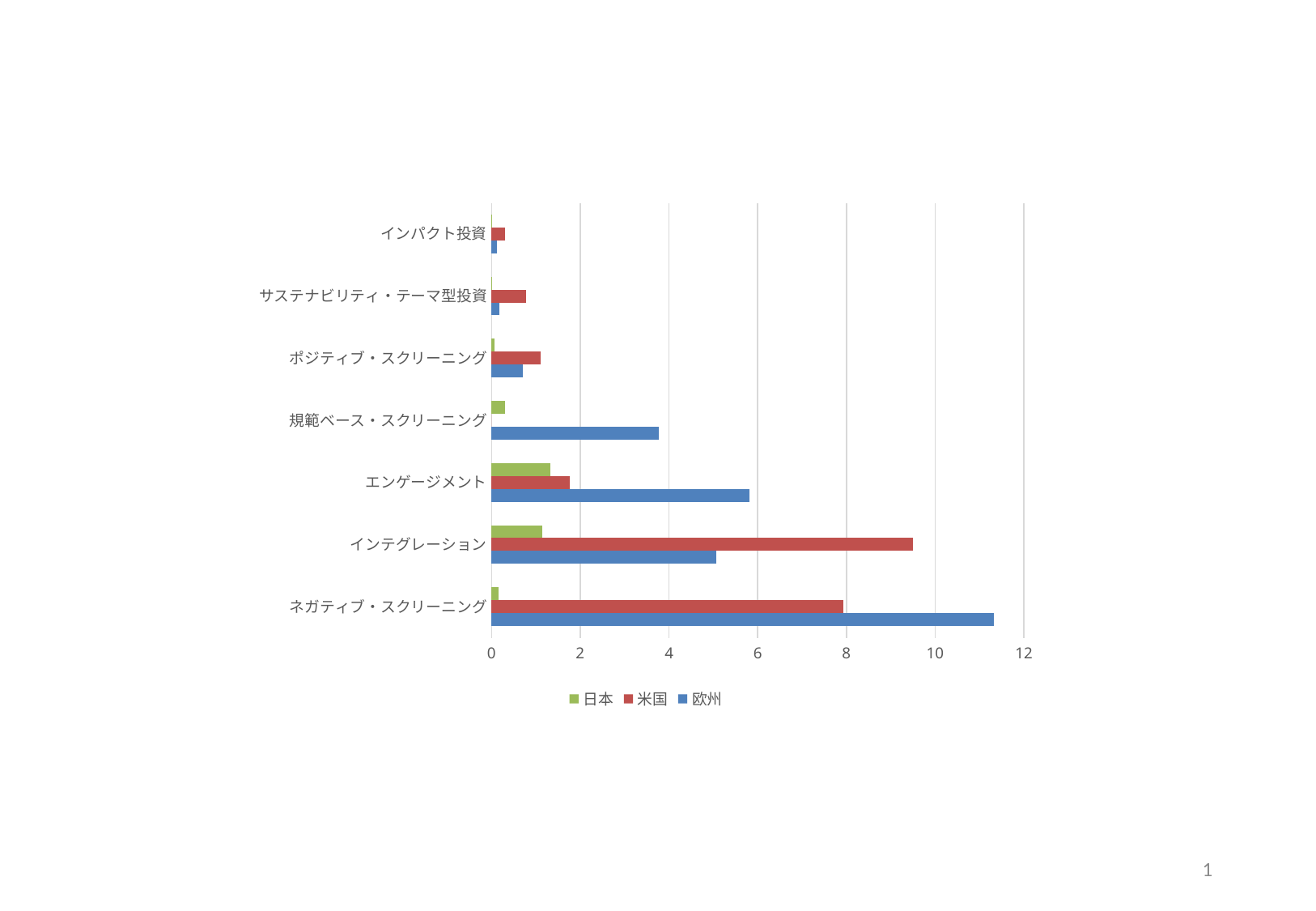
How many categories are shown on the vertical axis of the chart? 7 For ネガティブ・スクリーニング, which series has the larger value, 欧州 or 米国? 欧州 Is the value for 欧州 in ネガティブ・スクリーニング greater or less than 10? greater Which series is shown in blue in the legend? 欧州 Is the value for 欧州 in エンゲージメント greater or less than 4? greater Which category has the highest value for 米国? インテグレーション Which category has the highest value for 欧州? ネガティブ・スクリーニング How many series does the legend list? 3 For インテグレーション, which series has the larger value, 米国 or 欧州? 米国 What kind of chart is shown on the slide? bar chart Is the value for 米国 in インテグレーション greater or less than 8? greater